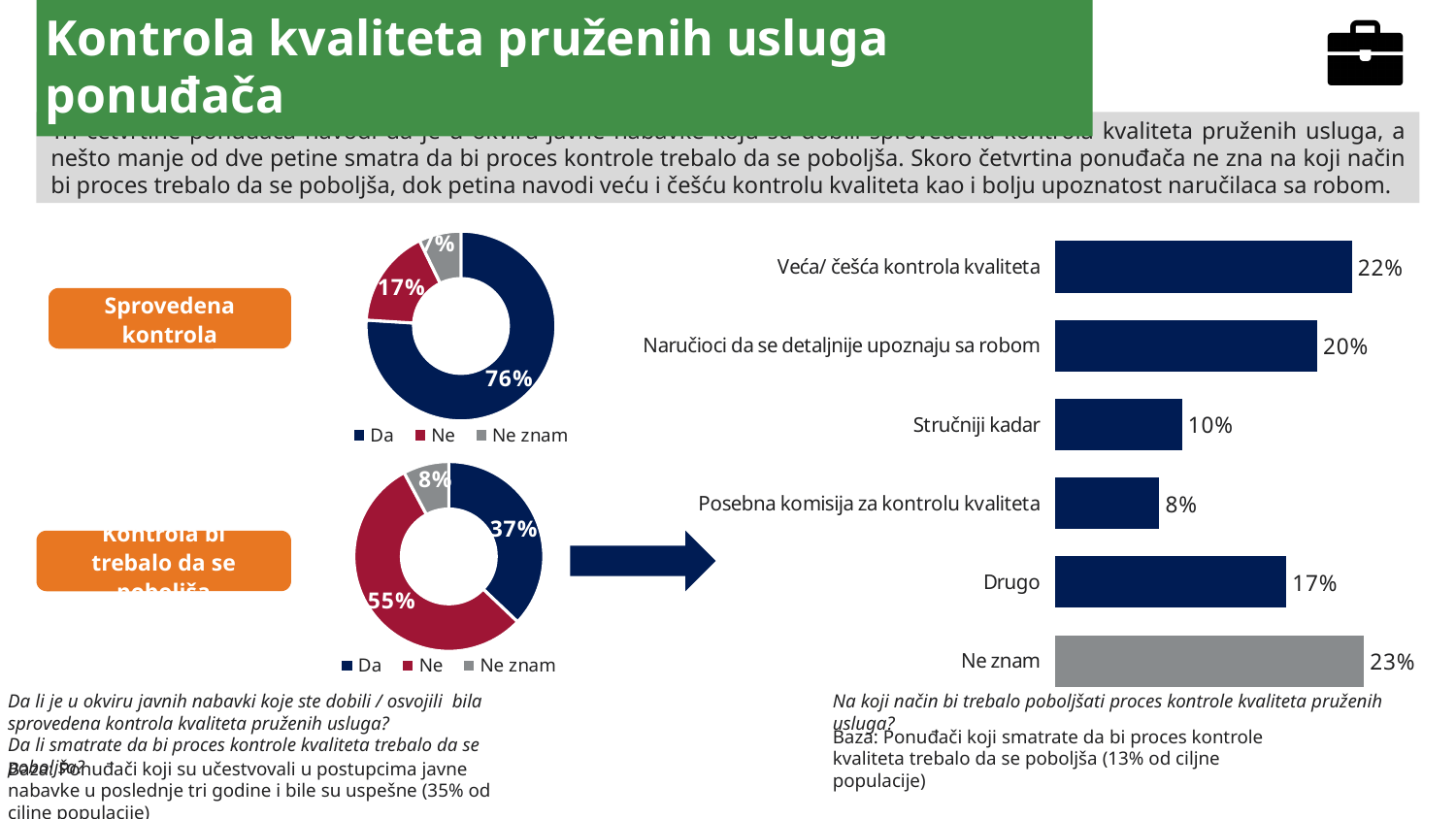
In the 'Kontrola bi trebalo da se poboljša' donut chart, what is the difference between 'Ne' and 'Da'? 18% In the 'Sprovedena kontrola' donut chart, what is the value for 'Da'? 76% In the bar chart on the right, what is the value for 'Stručniji kadar'? 10% In the bar chart on the right, which category has the lowest value? Posebna komisija za kontrolu kvaliteta In the 'Sprovedena kontrola' donut chart, which category has the smallest share? Ne znam How many categories does the bar chart on the right show? 6 In the bar chart on the right, which is larger: 'Veća/ češća kontrola kvaliteta' or 'Drugo'? Veća/ češća kontrola kvaliteta How many entries does the legend of the 'Sprovedena kontrola' donut chart list? 3 In the 'Kontrola bi trebalo da se poboljša' donut chart, what is the value for 'Ne'? 55% In the 'Sprovedena kontrola' donut chart, what is the value for 'Ne'? 17% In the bar chart on the right, which category has the highest value? Ne znam In the 'Kontrola bi trebalo da se poboljša' donut chart, which category has the largest share? Ne